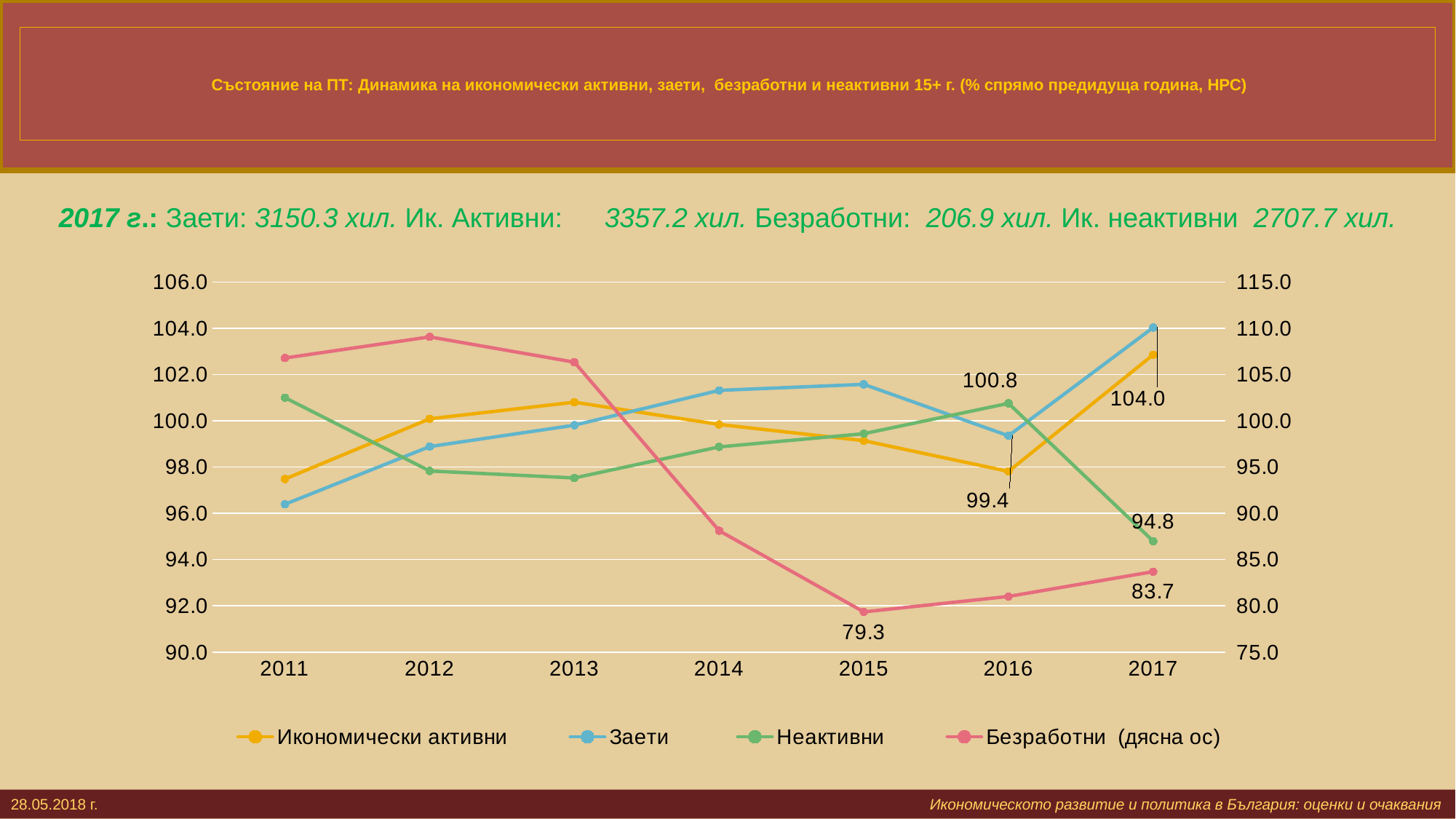
Is the value for Заети in 2017 greater or less than 102.0? greater How many years are shown on the x axis? 7 What is the value for Безработни in 2017? 83.7 Which series is plotted on the right axis? Безработни In which year is the Безработни series at its lowest? 2015 What is the value for Неактивни in 2016? 100.8 What is the value for Неактивни in 2017? 94.8 How many series does the legend list? 4 By how much did Безработни change from 2015 to 2017? 4.4 What is the value for Безработни in 2015? 79.3 What type of chart is shown on the slide? line chart What is the value for Заети in 2016? 99.4